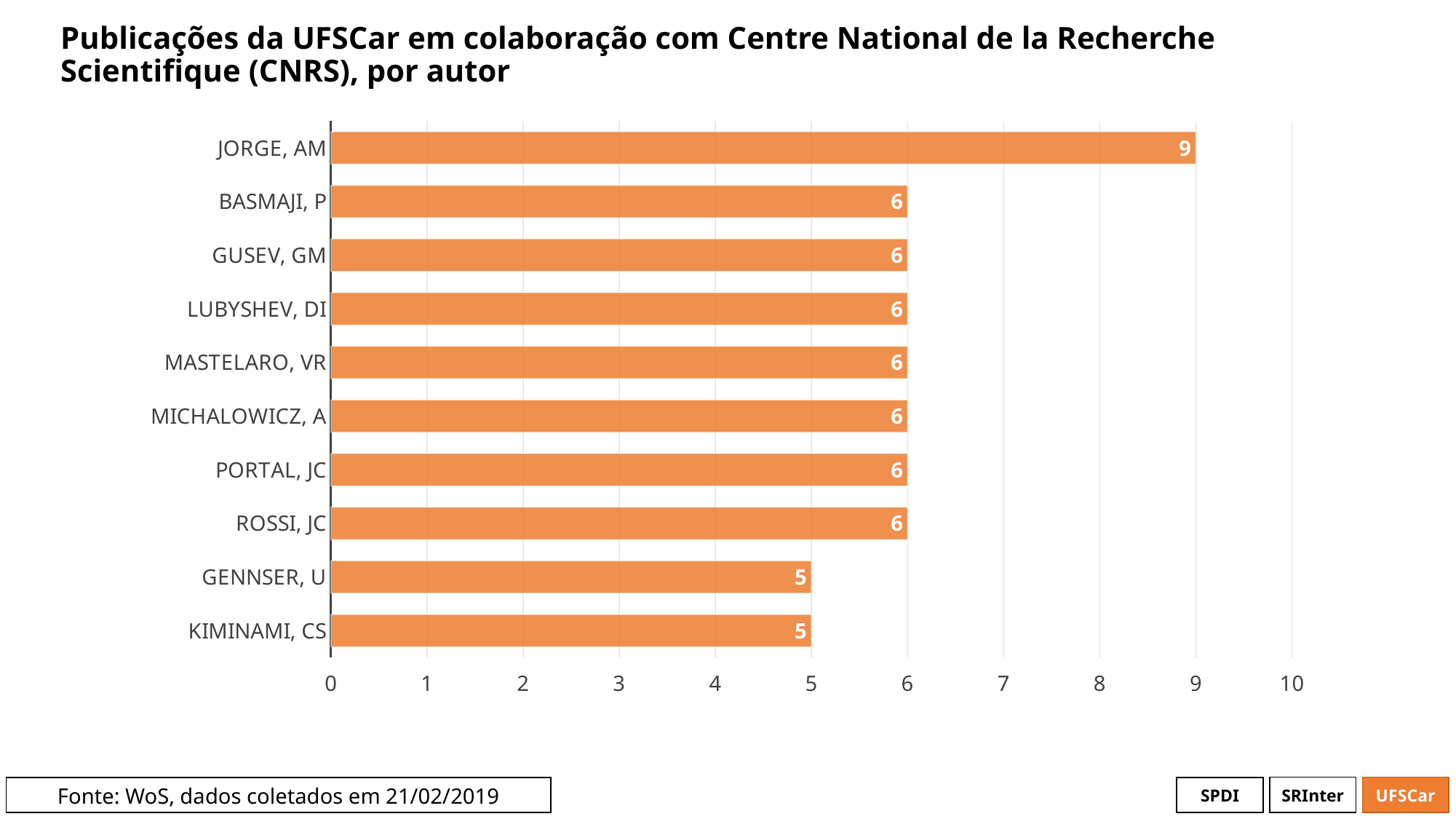
What is the value for MASTELARO, VR? 6 What kind of chart is shown on the slide? bar chart Which author has the highest number of publications? JORGE, AM What is the difference between the values for ROSSI, JC and KIMINAMI, CS? 1 How many authors are shown in the chart? 10 What is the difference between the values for JORGE, AM and BASMAJI, P? 3 What is the data source stated on the slide? WoS, dados coletados em 21/02/2019 How many authors have a value of 6? 7 Which is larger, the value for GUSEV, GM or the value for GENNSER, U? GUSEV, GM What is the value for GENNSER, U? 5 How many publications does JORGE, AM have? 9 Is the value for JORGE, AM greater or less than 8? greater